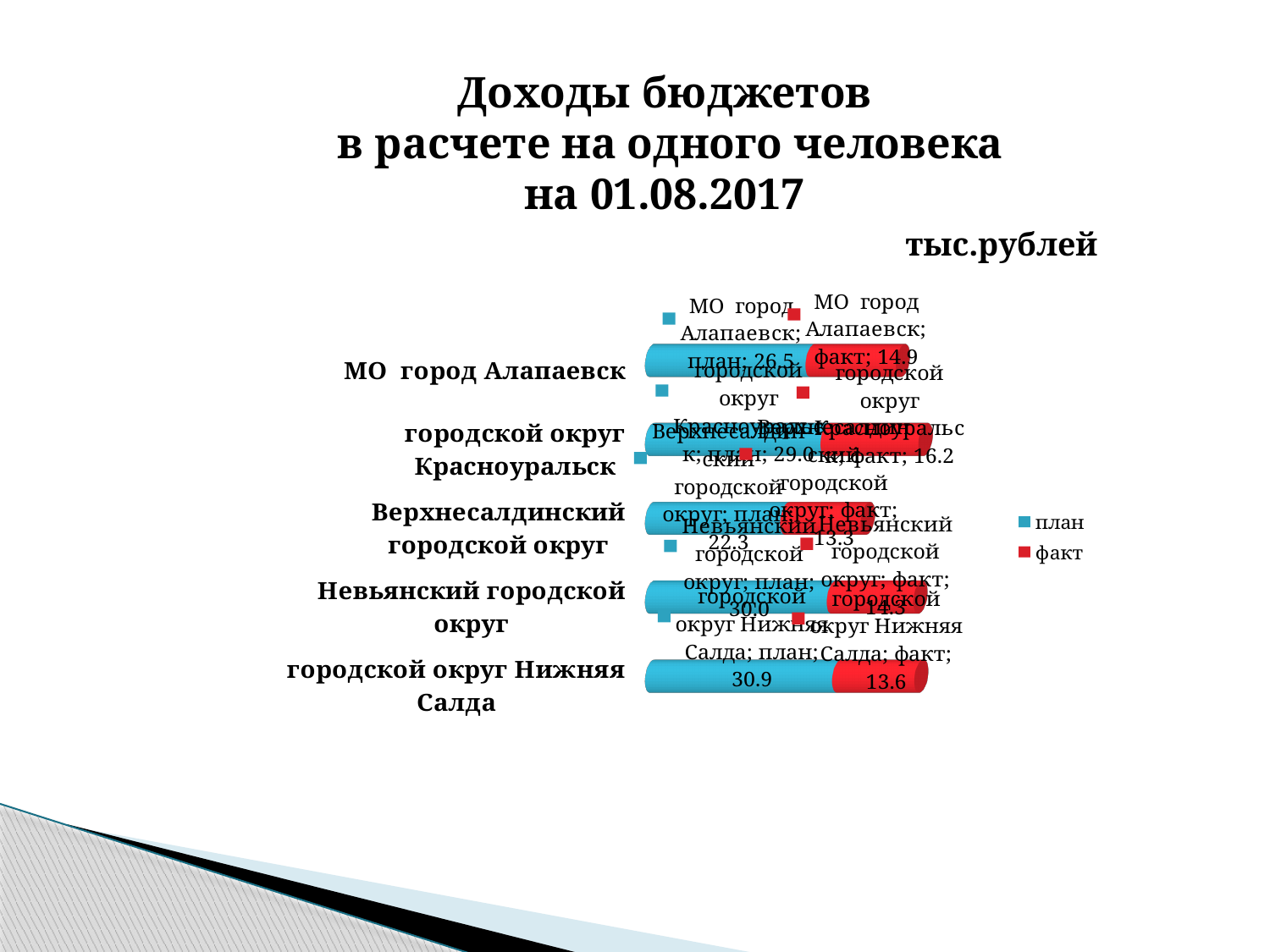
What kind of chart is shown on the slide? bar chart What is the план value for городской округ Нижняя Салда? 30.9 What colour represents the факт series in the legend? red What is the факт value for МО город Алапаевск? 14.9 How many series does the legend list? 2 How many municipalities (categories) are shown in the chart? 5 What is the факт value for Невьянский городской округ? 14.3 Which is larger: the план value for городской округ Красноуральск or for МО город Алапаевск? городской округ Красноуральск What is the план value for МО город Алапаевск? 26.5 Which municipality has the lowest план value? Верхнесалдинский городской округ What is the difference between план and факт for МО город Алапаевск? 11.6 Which municipality has the highest факт value? городской округ Красноуральск